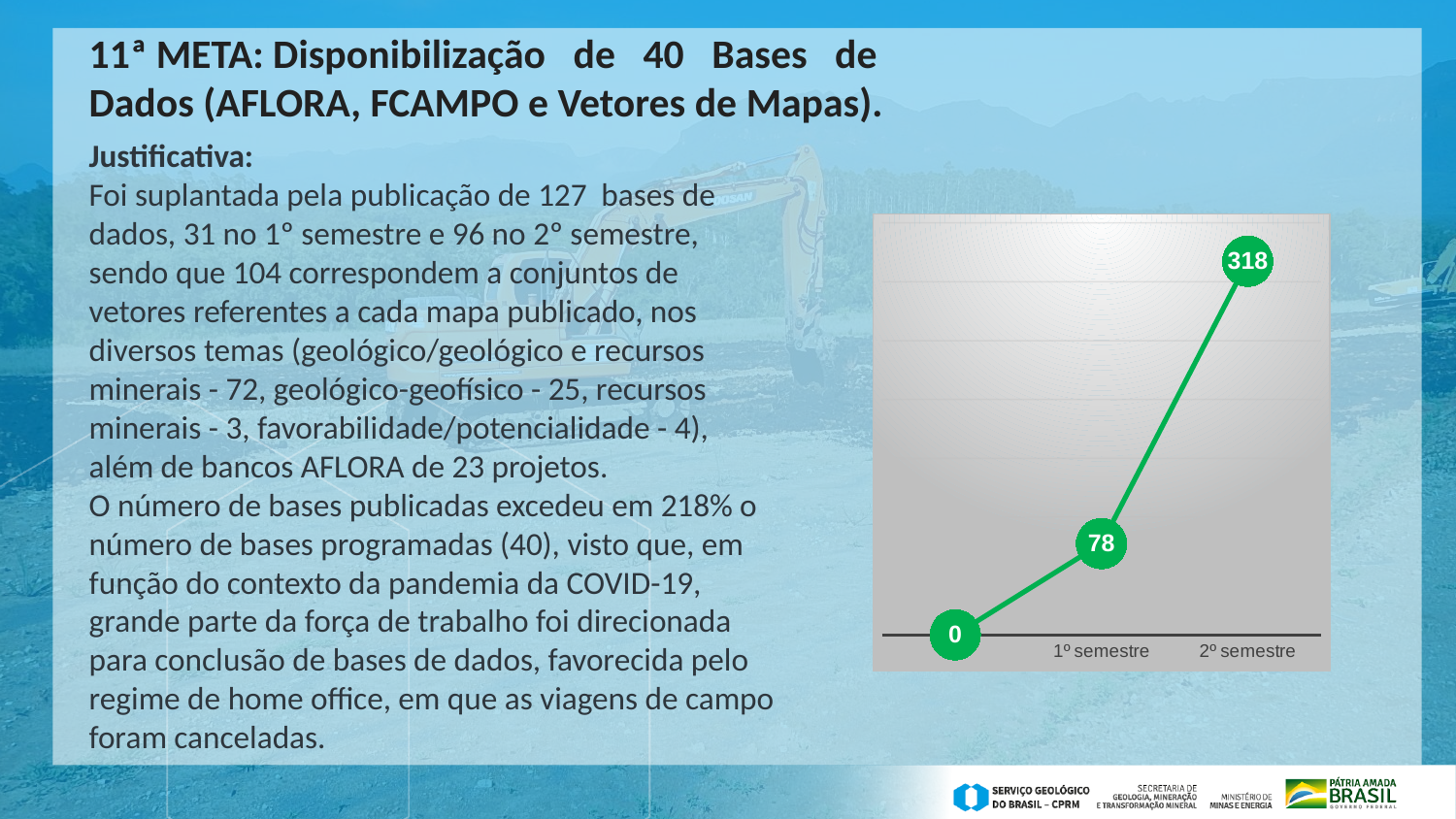
What kind of chart is shown on the slide? line chart Which labelled category has the lowest value? 1º semestre Which is larger, the value for 1º semestre or the value for 2º semestre? 2º semestre What is the difference between the values for 2º semestre and 1º semestre? 240 How many data points are plotted on the line? 3 What is the value of the first (leftmost) point on the line? 0 Which labelled category has the highest value? 2º semestre What is the value plotted for 1º semestre? 78 Do the values rise or fall from left to right along the x axis? rise What is the value plotted for 2º semestre? 318 What is the difference between the value for 1º semestre and the first point of the line? 78 What colour is the line in the chart? green